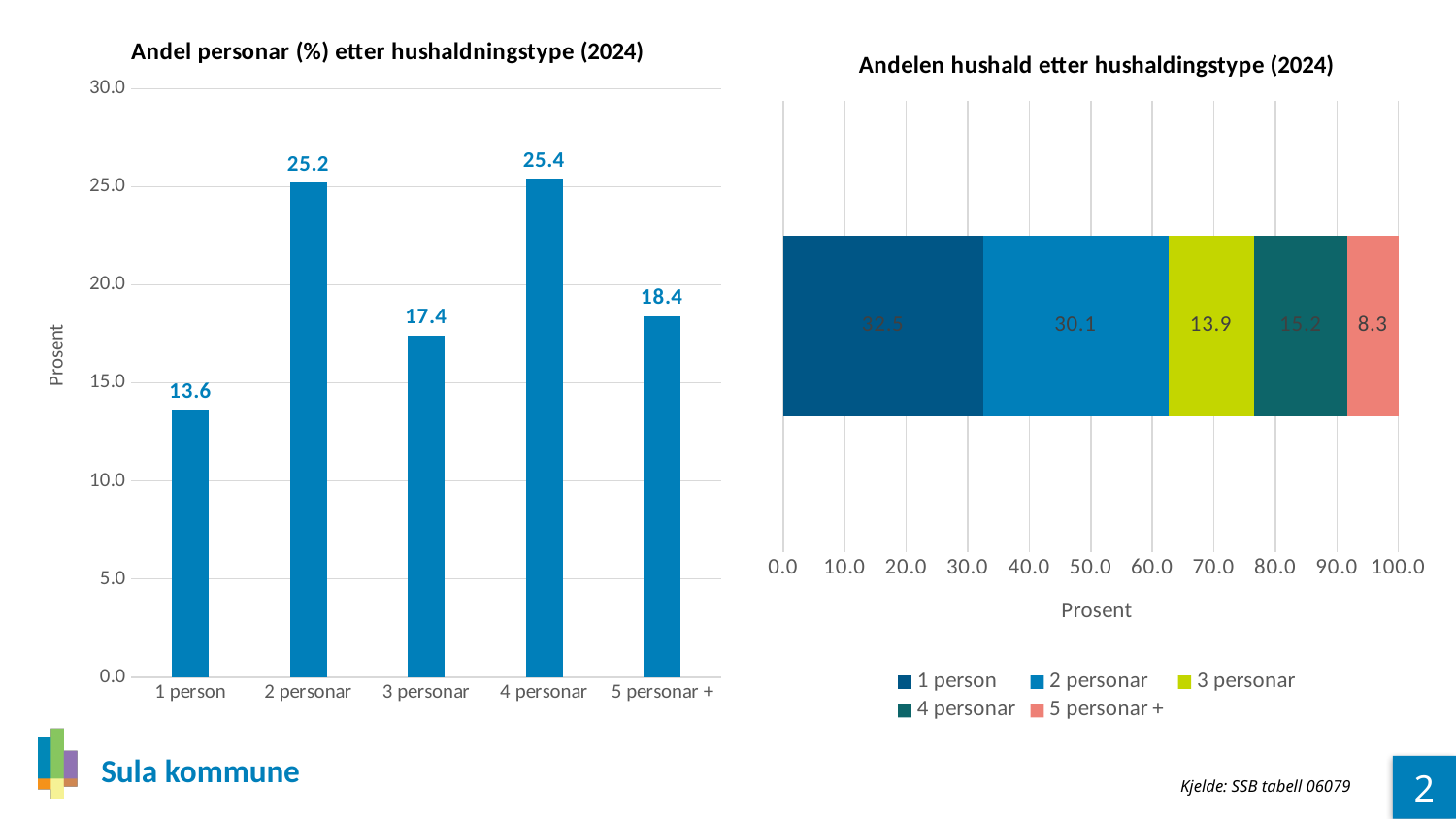
In the left chart 'Andel personar (%) etter hushaldningstype (2024)', what is the value for '1 person'? 13.6 In the right chart 'Andelen hushald etter hushaldingstype (2024)', is the value for '1 person' greater or less than 20.0? greater How many categories are shown on the x axis of the left chart 'Andel personar (%) etter hushaldningstype (2024)'? 5 How many series does the legend of the right chart 'Andelen hushald etter hushaldingstype (2024)' list? 5 In the left chart 'Andel personar (%) etter hushaldningstype (2024)', which is larger: the value for '3 personar' or for '5 personar +'? 5 personar + In the right chart 'Andelen hushald etter hushaldingstype (2024)', what is the value for '5 personar +'? 8.3 In the left chart 'Andel personar (%) etter hushaldningstype (2024)', which category has the lowest value? 1 person What kind of chart is the left chart, 'Andel personar (%) etter hushaldningstype (2024)'? bar chart In the right chart 'Andelen hushald etter hushaldingstype (2024)', what is the value for '2 personar'? 30.1 In the left chart 'Andel personar (%) etter hushaldningstype (2024)', what is the difference between the values for '5 personar +' and '1 person'? 4.8 In the left chart 'Andel personar (%) etter hushaldningstype (2024)', what is the value for '3 personar'? 17.4 In the left chart 'Andel personar (%) etter hushaldningstype (2024)', which category has the highest value? 4 personar